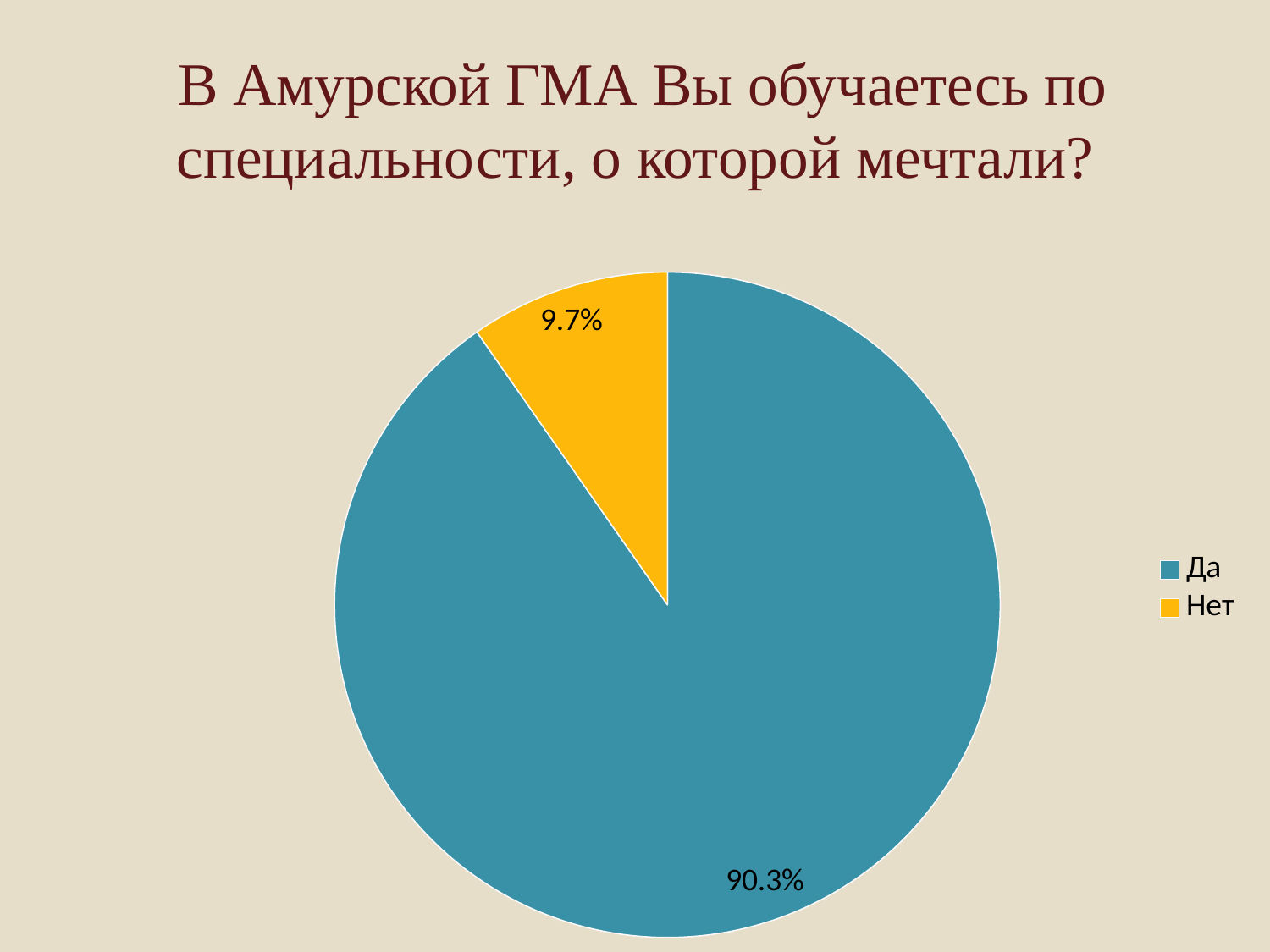
Which answer has the smallest share of the pie? Нет How many entries does the legend list? 2 What colour is the "Нет" slice? yellow What share of the pie does the "Нет" slice represent? 9.7% What is the title of the slide above the chart? В Амурской ГМА Вы обучаетесь по специальности, о которой мечтали? Which answer has the largest share of the pie? Да Which slice is larger, "Да" or "Нет"? Да What kind of chart is shown on the slide? pie chart How many slices does the pie chart have? 2 What percentage of respondents answered "Нет"? 9.7% What is the difference in percentage points between the "Да" and "Нет" slices? 80.6 What percentage of respondents answered "Да"? 90.3%